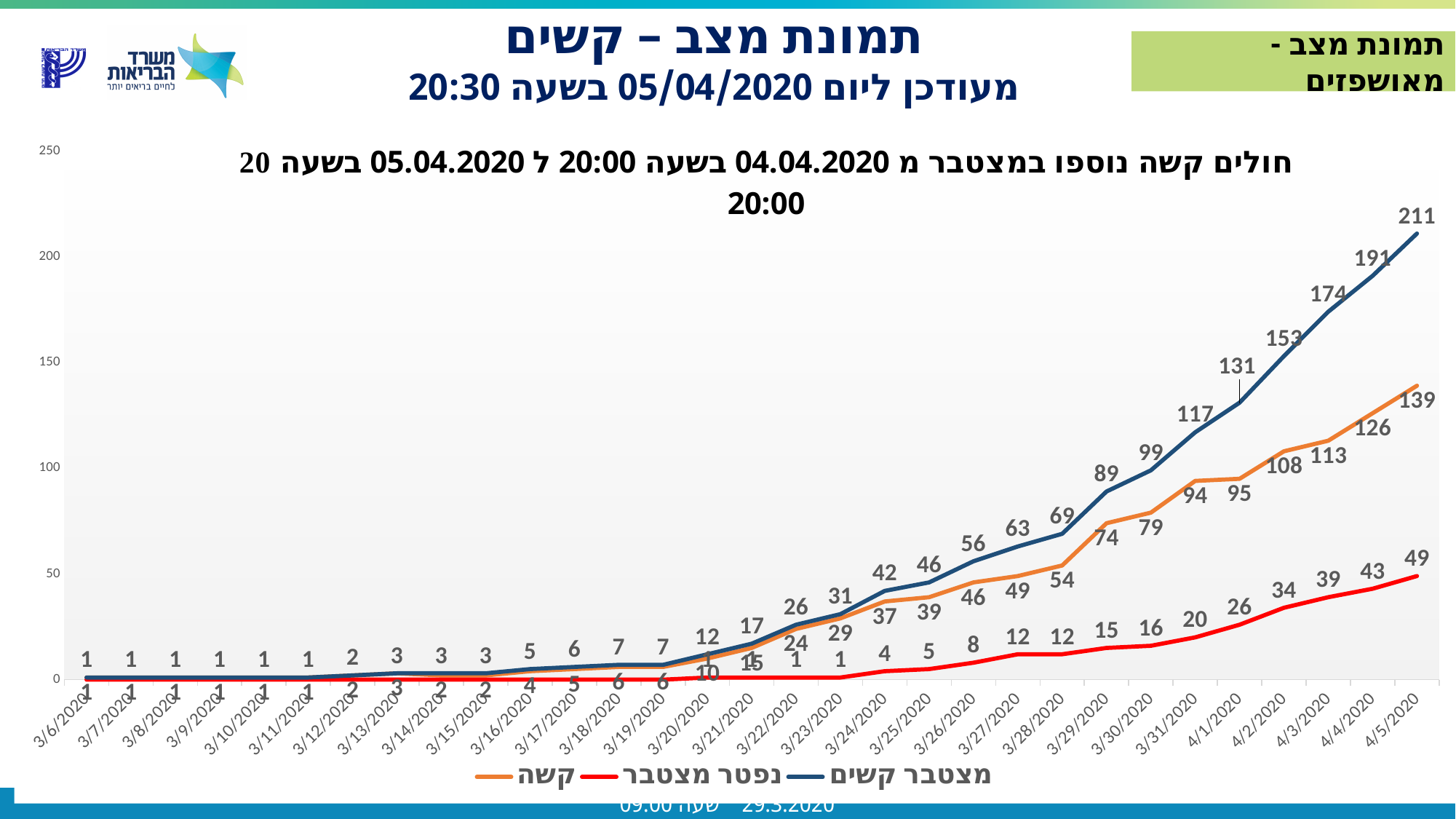
What is the value of מצטבר קשים on 3/29/2020? 89 What is the value of נפטר מצטבר on 4/5/2020? 49 How many series does the chart legend list? 3 What is the value of מצטבר קשים on 4/5/2020? 211 On which date does מצטבר קשים reach its highest value? 4/5/2020 What is the difference between קשה and נפטר מצטבר on 4/5/2020? 90 By how much did מצטבר קשים increase from 4/4/2020 to 4/5/2020? 20 Does the מצטבר קשים series rise or fall over the dates shown? rise What is the value of קשה on 4/5/2020? 139 What kind of chart is shown on the slide? line chart On 4/5/2020, which is larger: קשה or נפטר מצטבר? קשה What is the value of נפטר מצטבר on 4/1/2020? 26